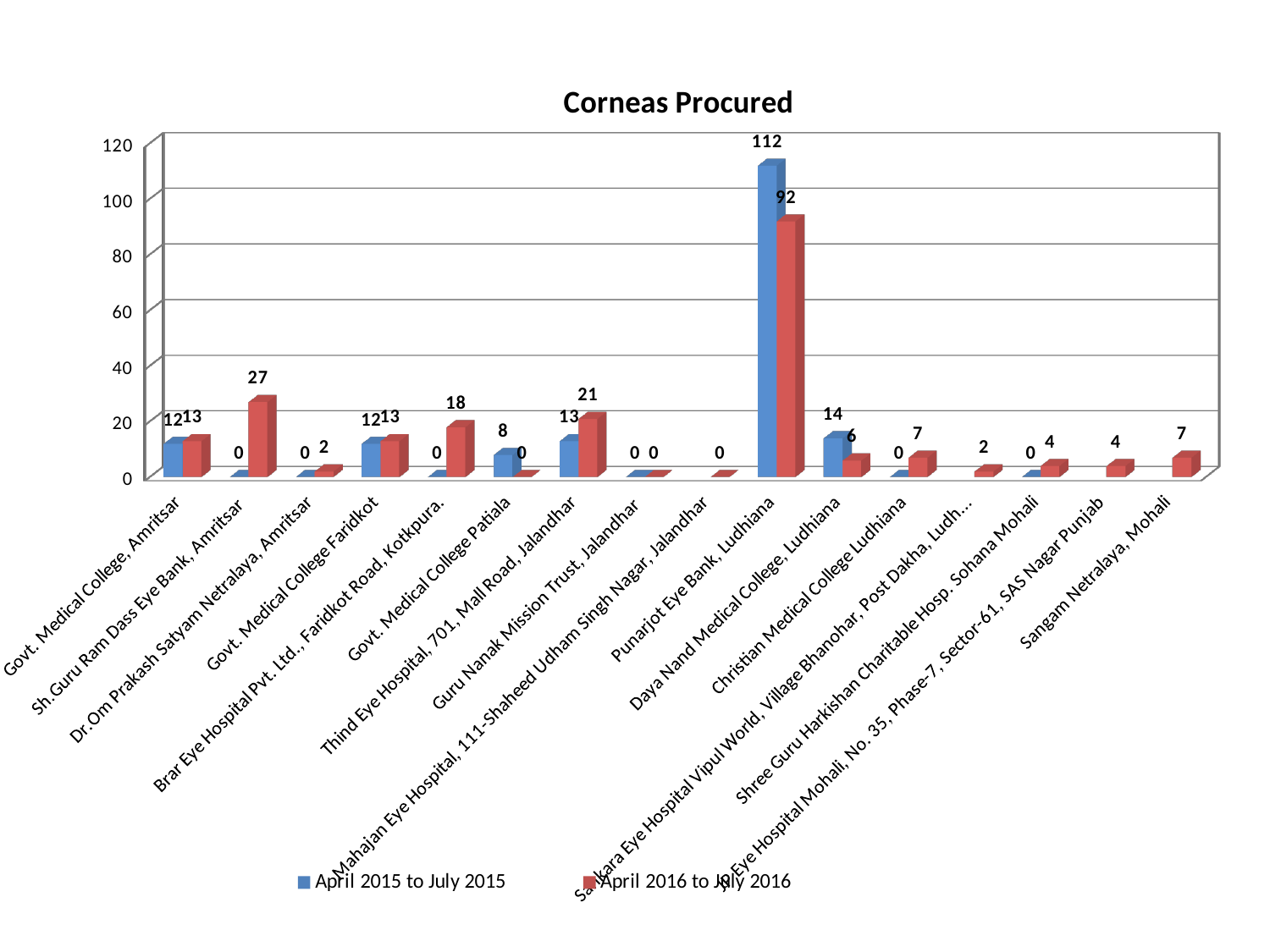
Is the April 2016 to July 2016 value for Punarjot Eye Bank, Ludhiana greater or less than 100? less Which is larger for Daya Nand Medical College, Ludhiana: the April 2015 to July 2015 value or the April 2016 to July 2016 value? April 2015 to July 2015 How many series does the legend list? 2 What is the title of the chart? Corneas Procured How many corneas were procured by Punarjot Eye Bank, Ludhiana in April 2015 to July 2015? 112 What kind of chart is shown on the slide? bar chart What is the value for Thind Eye Hospital, 701, Mall Road, Jalandhar in April 2016 to July 2016? 21 What is the value for Govt. Medical College Patiala in April 2015 to July 2015? 8 What is the difference between the April 2016 to July 2016 value for Brar Eye Hospital Pvt. Ltd., Faridkot Road, Kotkpura. and that for Christian Medical College Ludhiana? 11 How many corneas were procured by Sh.Guru Ram Dass Eye Bank, Amritsar in April 2016 to July 2016? 27 Which institution has the highest value in April 2016 to July 2016? Punarjot Eye Bank, Ludhiana What is the difference between the April 2015 to July 2015 and April 2016 to July 2016 values for Punarjot Eye Bank, Ludhiana? 20